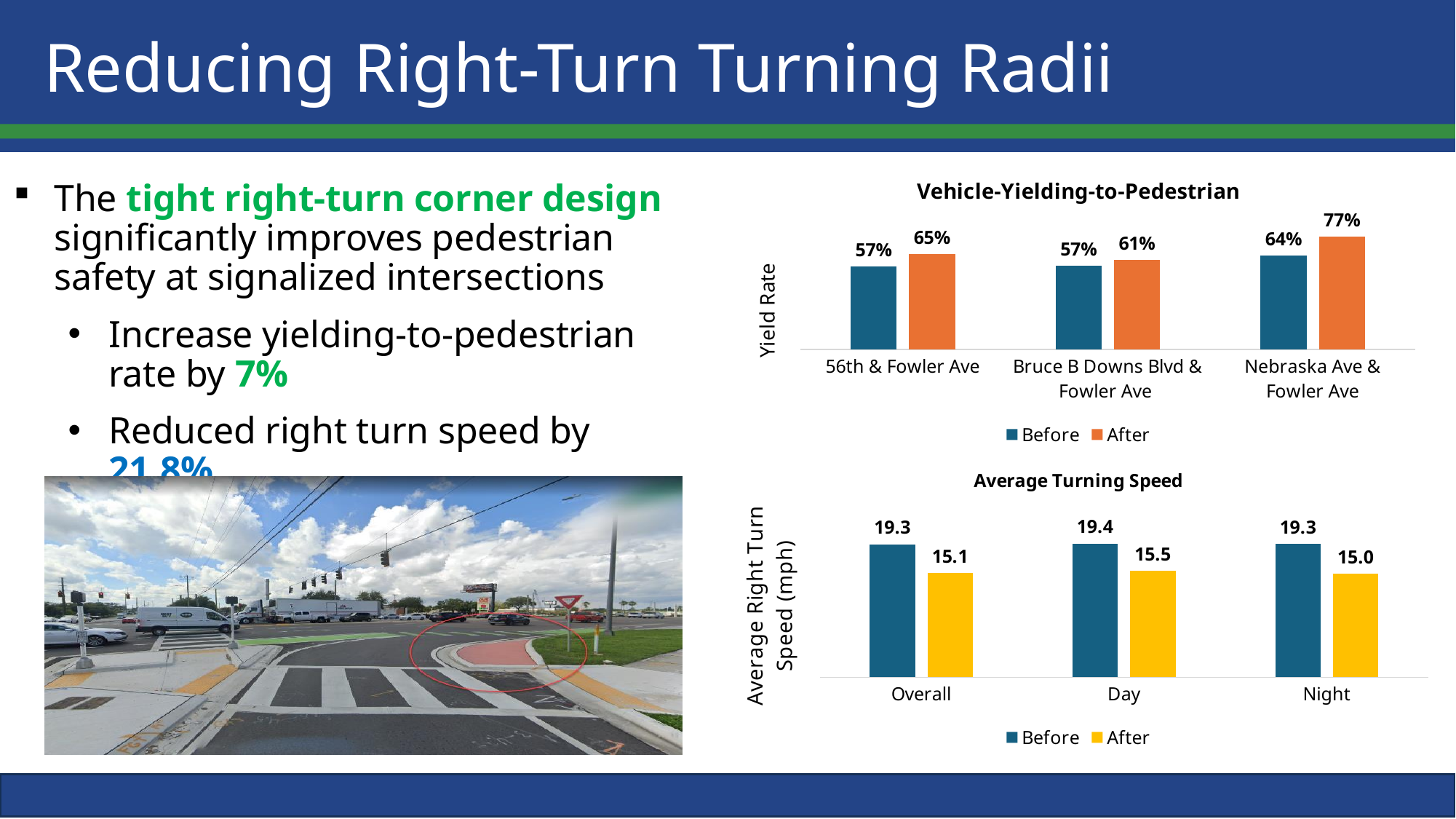
In the Average Turning Speed chart, what is the After speed for Day? 15.5 In the Average Turning Speed chart, what is the difference between the Before and After speeds for Night? 4.3 In the Vehicle-Yielding-to-Pedestrian chart, how many series does the legend list? 2 In the Average Turning Speed chart, is the Before or After value larger for Day? Before In the Vehicle-Yielding-to-Pedestrian chart, what is the Before yield rate at 56th & Fowler Ave? 57% In the Average Turning Speed chart, what is the Before speed for Overall? 19.3 In the Vehicle-Yielding-to-Pedestrian chart, what is the After yield rate at Nebraska Ave & Fowler Ave? 77% In the Average Turning Speed chart, which category has the lowest After speed? Night In the Vehicle-Yielding-to-Pedestrian chart, what is the difference between the After and Before yield rates at 56th & Fowler Ave? 8% In the Vehicle-Yielding-to-Pedestrian chart, which intersection has the highest After yield rate? Nebraska Ave & Fowler Ave What kind of chart is the Average Turning Speed chart? Bar chart In the Vehicle-Yielding-to-Pedestrian chart, how many intersections are shown on the x axis? 3